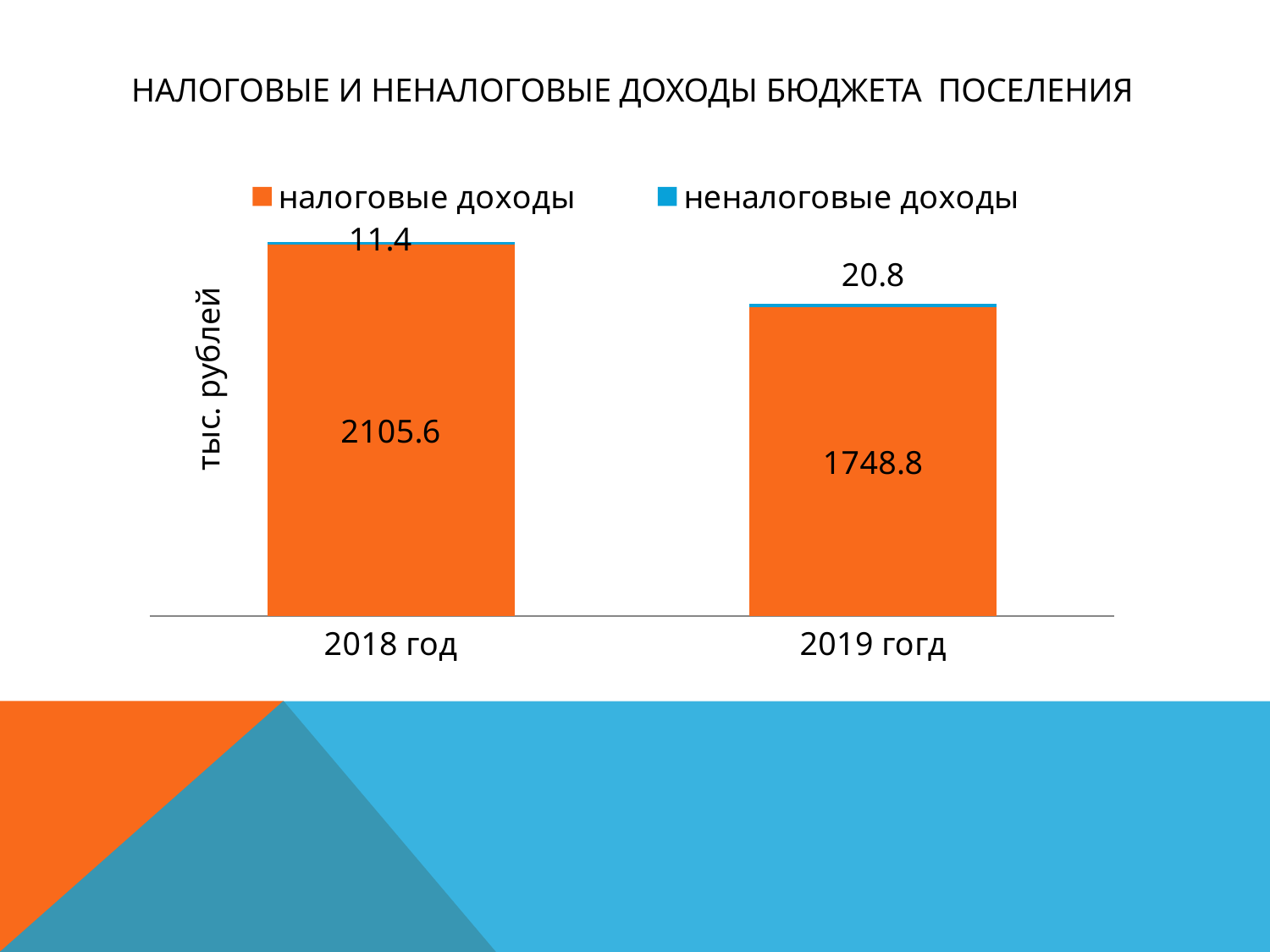
What is the total of the stacked bar for 2019 годг? 1769.6 What is the value of неналоговые доходы for 2018 год? 11.4 What kind of chart is shown on the slide? Stacked bar chart What is the difference between неналоговые доходы in 2019 годг and 2018 год? 9.4 How many series does the legend list? 2 What is the value of неналоговые доходы for 2019 годг? 20.8 What is the difference between налоговые доходы in 2018 год and 2019 годг? 356.8 What is the value of налоговые доходы for 2018 год? 2105.6 What is the label of the vertical axis? тыс. рублей Which year has the lower value of неналоговые доходы? 2018 год What is the value of налоговые доходы for 2019 годг? 1748.8 Which year has the higher value of налоговые доходы? 2018 год